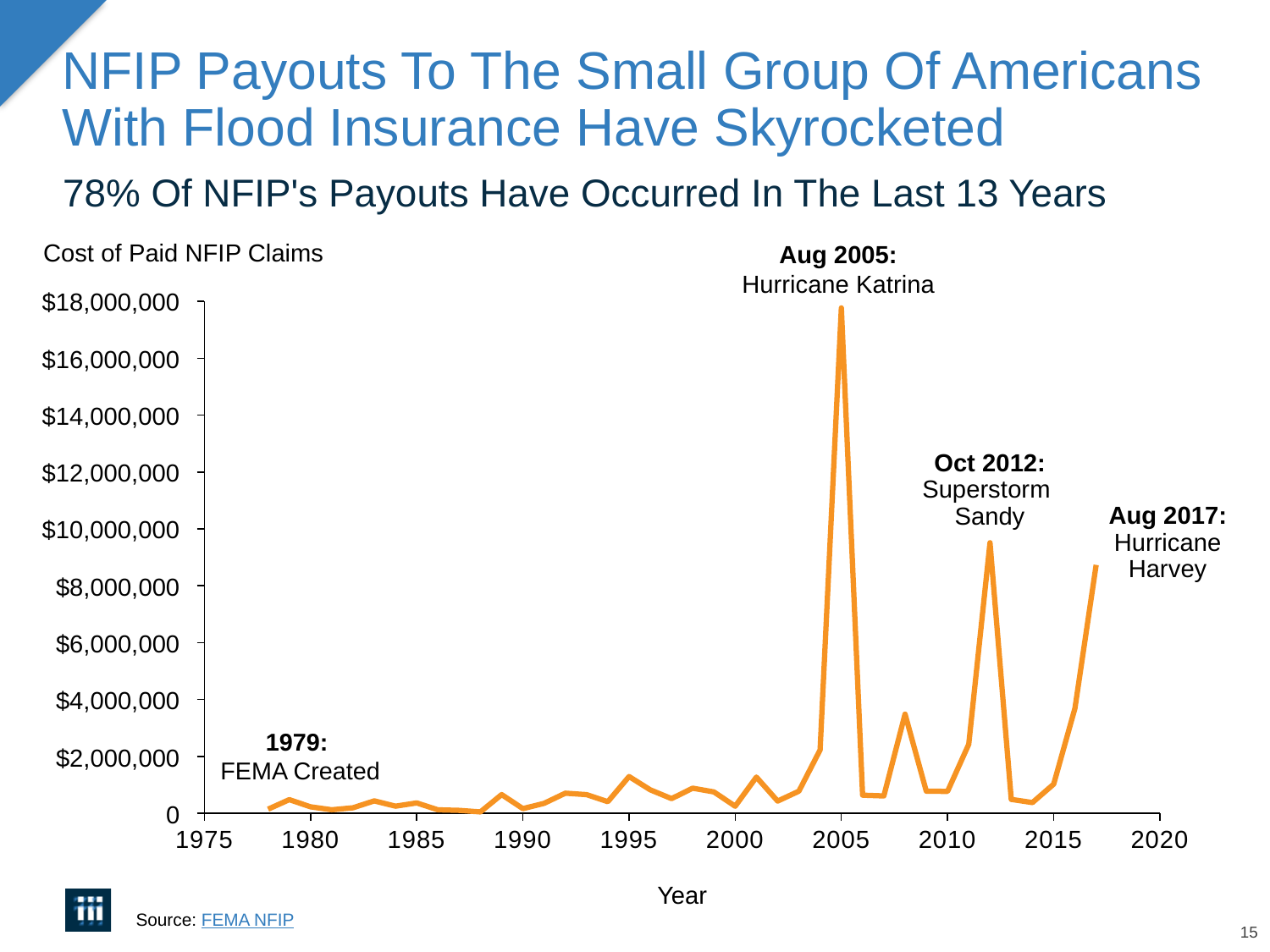
Is the value for 2008 greater or less than $4,000,000? less What is the label on the vertical axis of the chart? Cost of Paid NFIP Claims In which year is the cost of paid NFIP claims highest? 2005 Is the value for 2005 greater or less than $16,000,000? greater Is the value for 2017 greater or less than $10,000,000? less What kind of chart is shown on the slide? line chart Which year has the larger cost of paid NFIP claims, 2008 or 2012? 2012 Which year has the larger cost of paid NFIP claims, 2005 or 2012? 2005 Which event is annotated at the highest peak of the line in 2005? Hurricane Katrina Overall, do the costs of paid NFIP claims rise or fall from the late 1970s to 2017? rise